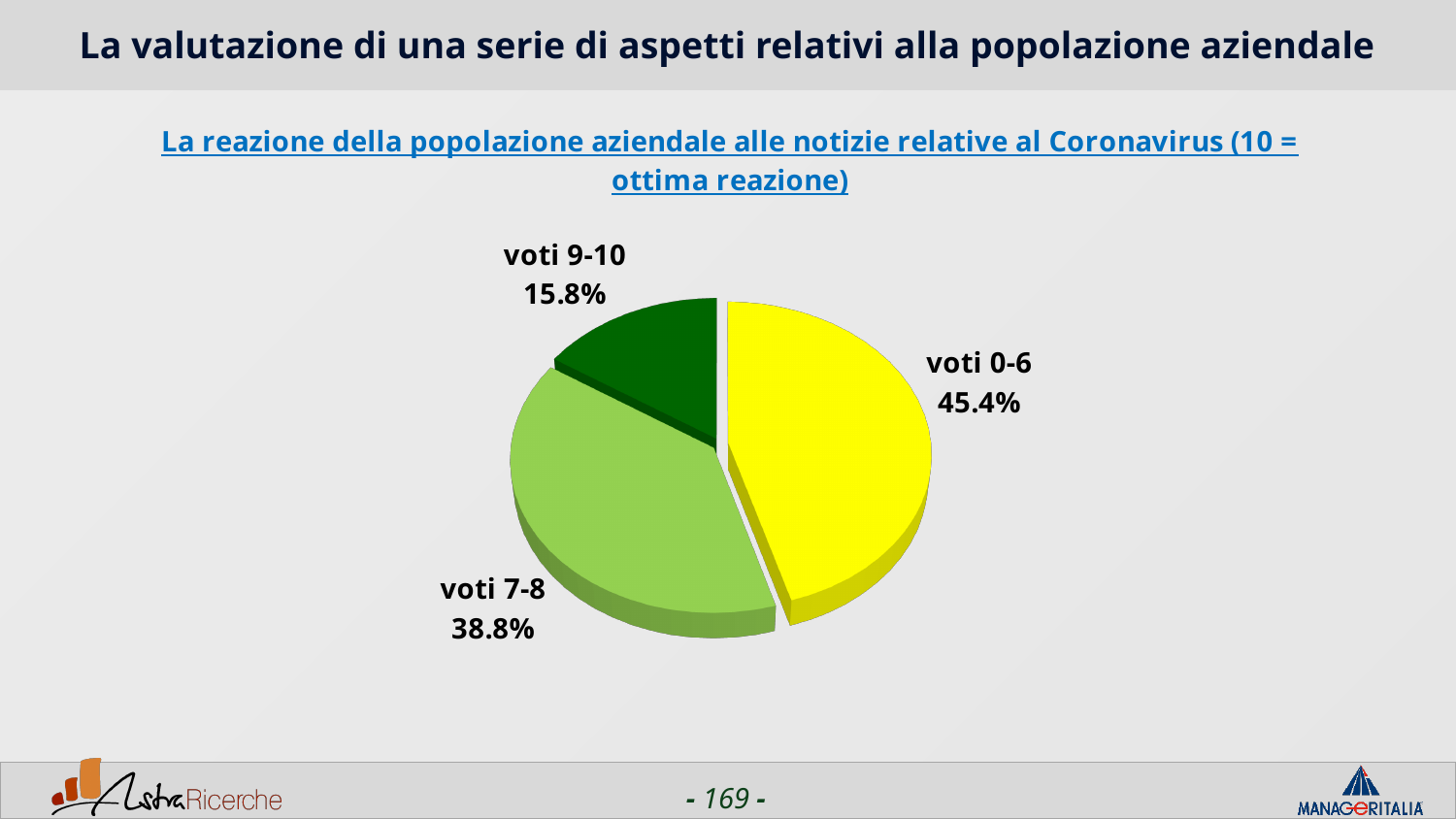
What share of the pie is labelled 'voti 9-10'? 15.8% Which slice of the pie is the smallest? voti 9-10 What share of the pie is labelled 'voti 0-6'? 45.4% Which is larger, the share for 'voti 7-8' or the share for 'voti 9-10'? voti 7-8 What share of the pie is labelled 'voti 7-8'? 38.8% What is the difference in percentage points between 'voti 7-8' and 'voti 9-10'? 23 Which slice of the pie is the largest? voti 0-6 What colour is the 'voti 0-6' slice of the pie? yellow What is the combined share of 'voti 7-8' and 'voti 9-10'? 54.6% What is the difference in percentage points between 'voti 0-6' and 'voti 7-8'? 6.6 How many slices does the pie chart have? 3 What kind of chart is shown on the slide? pie chart